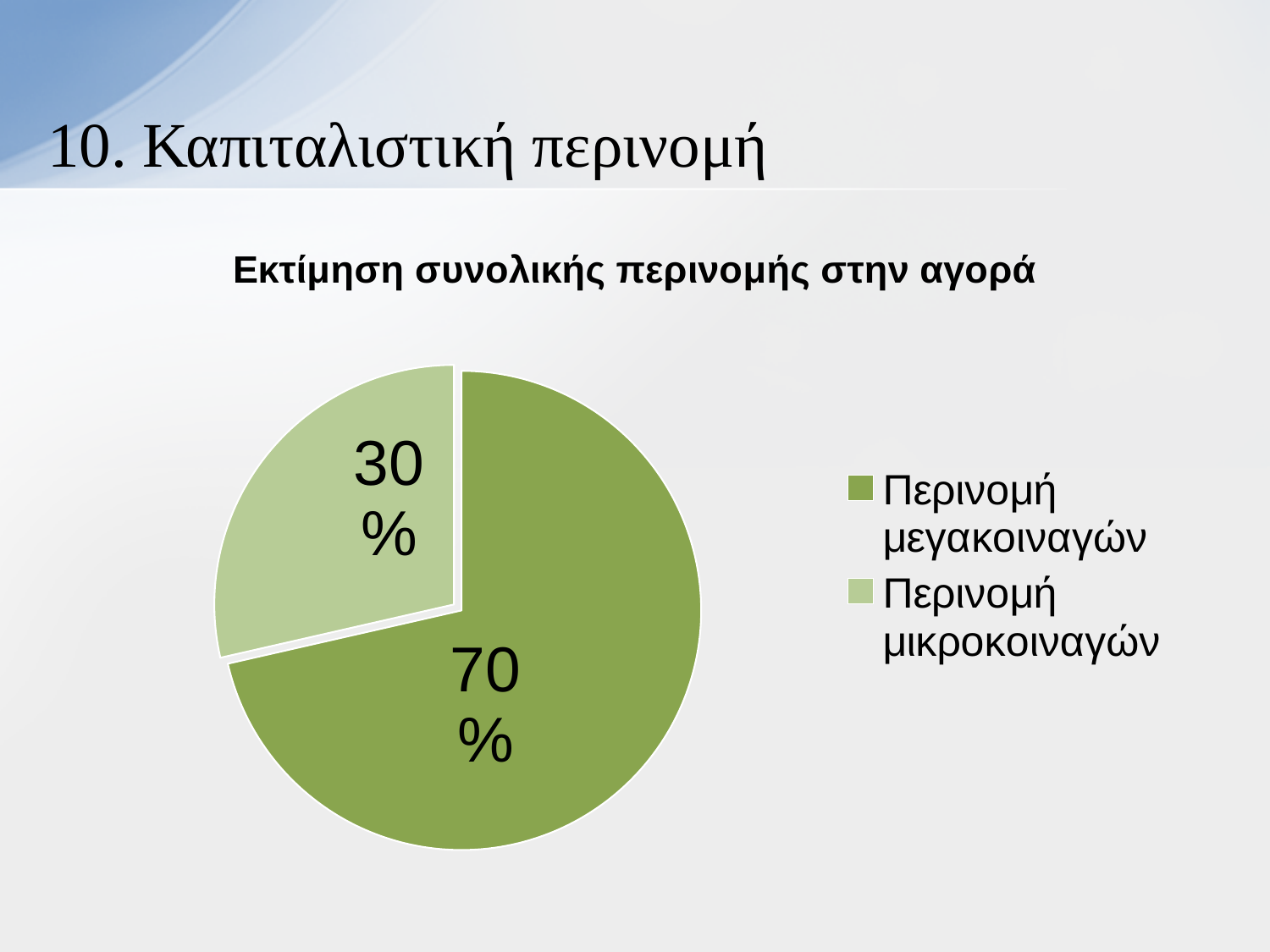
How many entries does the legend list? 2 Which is larger, the slice for Περινομή μεγακοιναγών or the slice for Περινομή μικροκοιναγών? Περινομή μεγακοιναγών Which category has the largest slice of the pie? Περινομή μεγακοιναγών What is the difference in percentage points between Περινομή μεγακοιναγών and Περινομή μικροκοιναγών? 40% What share of the pie does Περινομή μεγακοιναγών take? 70% What is the title of the chart? Εκτίμηση συνολικής περινομής στην αγορά Which legend entry is shown in the lighter green colour? Περινομή μικροκοιναγών What kind of chart is shown on the slide? pie chart What share of the pie does Περινομή μικροκοιναγών take? 30% How many slices does the pie chart have? 2 Which category has the smallest slice of the pie? Περινομή μικροκοιναγών